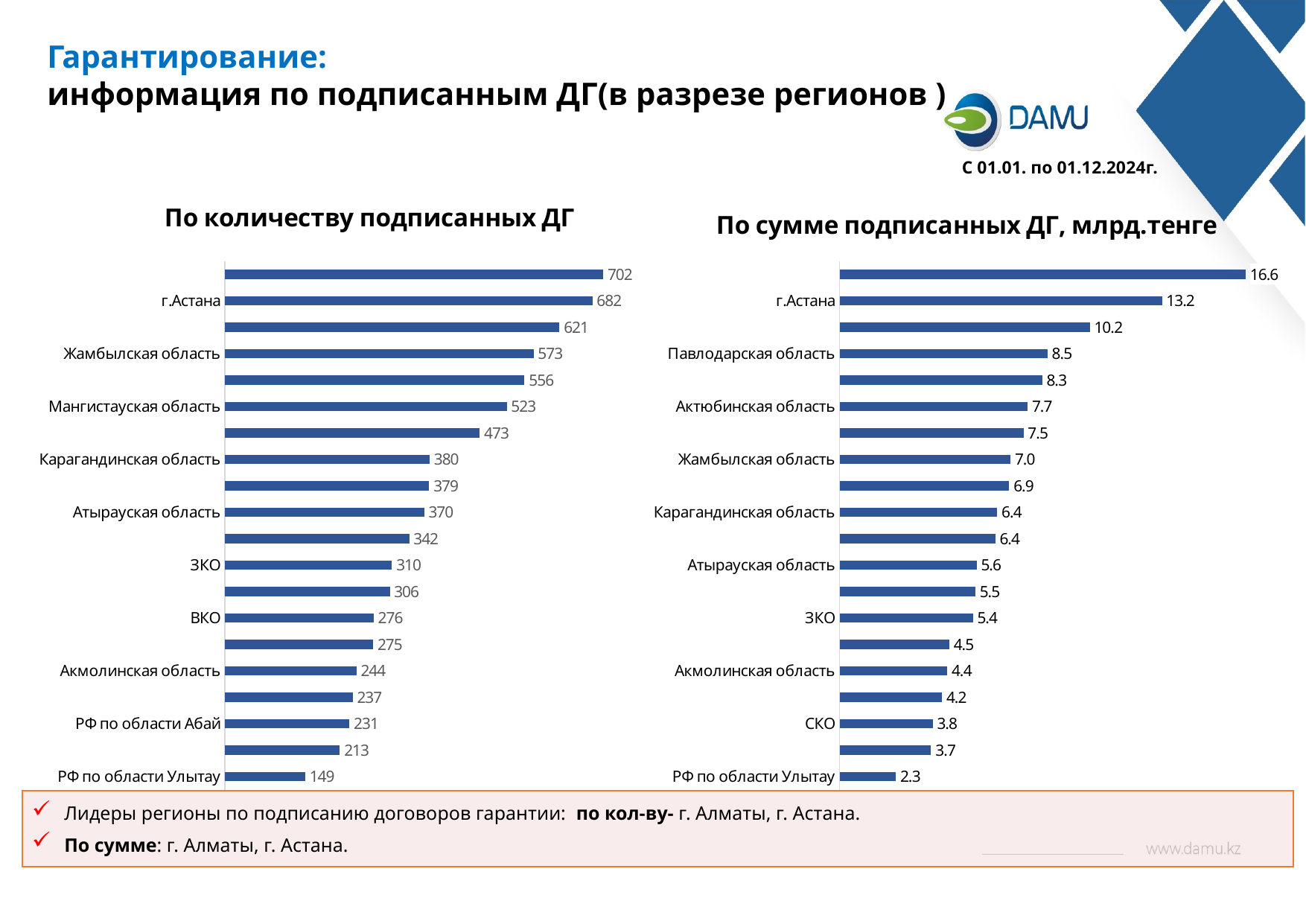
In the chart 'По сумме подписанных ДГ, млрд.тенге', what is the value for Павлодарская область? 8.5 How many bars are plotted in the chart 'По количеству подписанных ДГ'? 20 In the chart 'По сумме подписанных ДГ, млрд.тенге', which labelled region has the lowest value? РФ по области Улытау In the chart 'По количеству подписанных ДГ', what is the value for Жамбылская область? 573 In the chart 'По количеству подписанных ДГ', which labelled region has the lowest value? РФ по области Улытау What unit is stated in the title of the right-hand chart? млрд.тенге In the chart 'По количеству подписанных ДГ', what is the difference between г.Астана and Мангистауская область? 159 In the chart 'По сумме подписанных ДГ, млрд.тенге', what is the value for ЗКО? 5.4 In the chart 'По сумме подписанных ДГ, млрд.тенге', what is the difference between г.Астана and Карагандинская область? 6.8 What type of chart is 'По сумме подписанных ДГ, млрд.тенге'? Bar chart In the chart 'По количеству подписанных ДГ', which is larger, ЗКО or ВКО? ЗКО In the chart 'По количеству подписанных ДГ', what is the value for г.Астана? 682